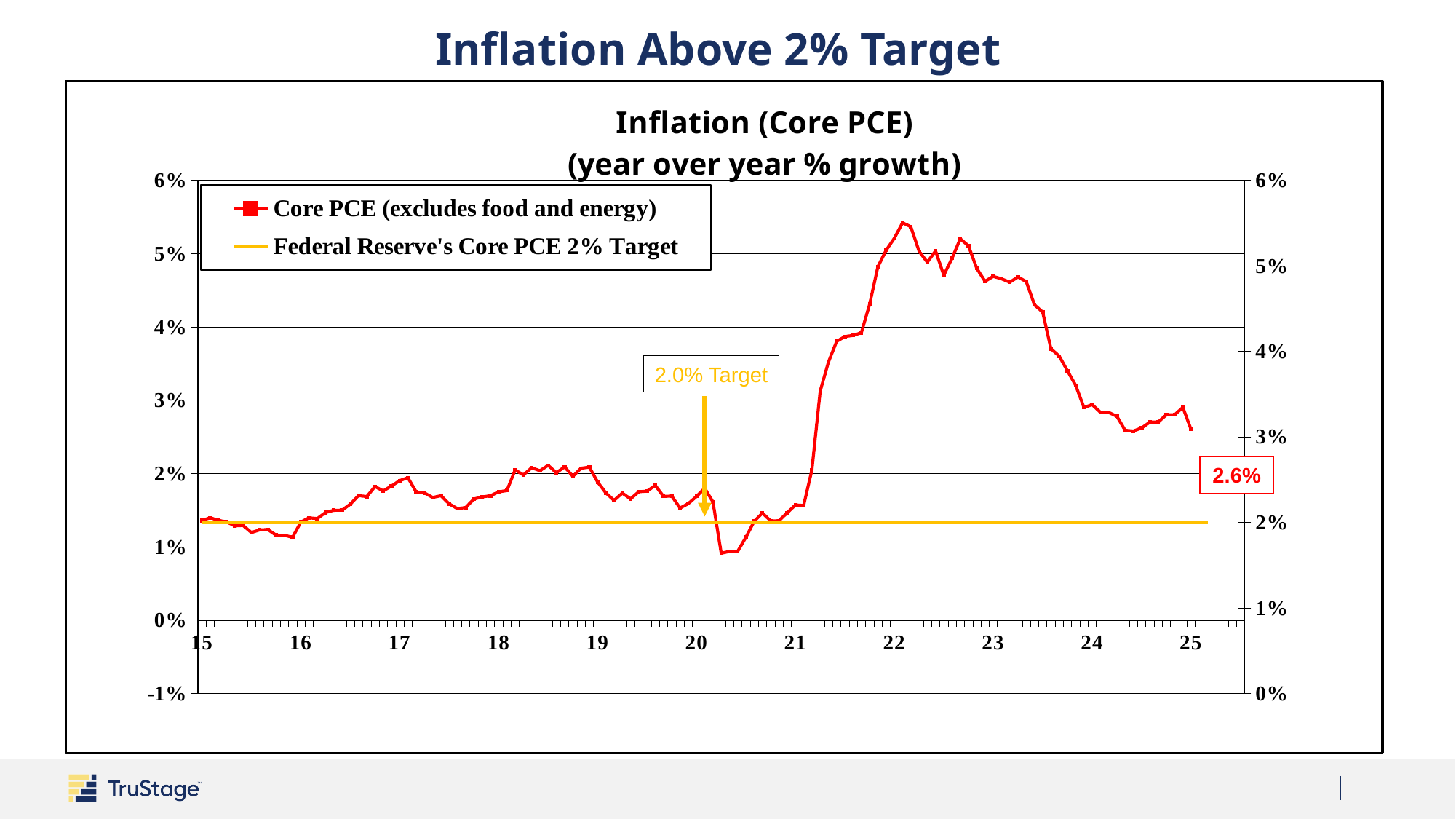
What target level does the Federal Reserve's Core PCE target line represent? 2.0% What is the most recent Core PCE value labeled on the chart? 2.6% What type of chart is shown on the slide? line chart Which is larger, the Core PCE value in 2022 or in 2025? 2022 In which year on the x axis does the Core PCE line reach its highest point? 22 What is the title of the chart? Inflation (Core PCE) (year over year % growth) Is the peak Core PCE value around 2022 greater or less than 5%? greater What colour is the Federal Reserve's Core PCE 2% Target line? yellow Is the latest Core PCE value (2.6%) greater or less than the 2.0% target? greater In which year on the x axis does the Core PCE line reach its lowest point? 20 Does the Core PCE line rise or fall between 2022 and 2024? fall How many series does the legend list? 2